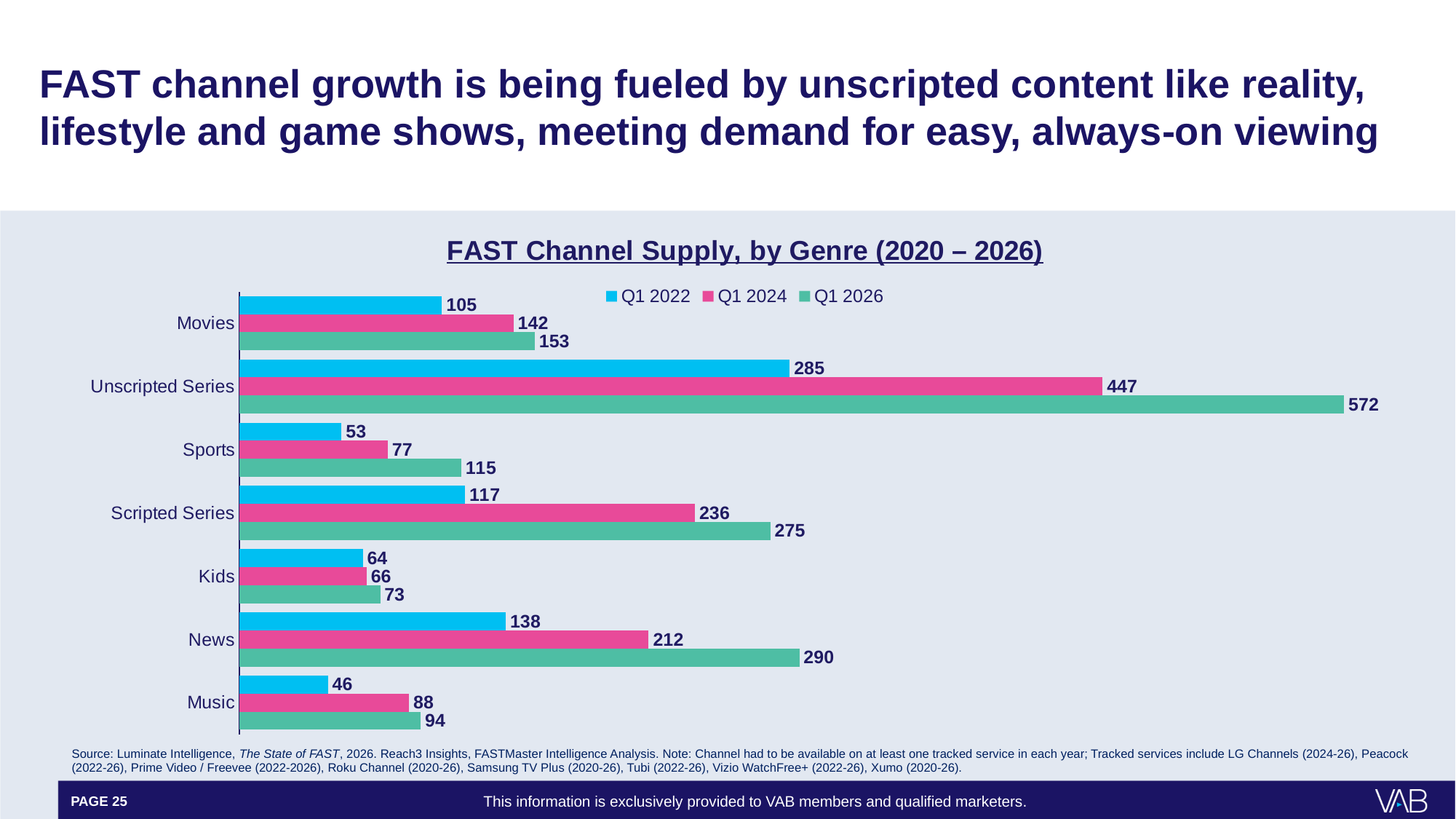
Which is larger, the Q1 2026 value for News or the Q1 2026 value for Scripted Series? News Which genre has the highest Q1 2026 value? Unscripted Series What kind of chart is shown on the slide? Bar chart How many series does the legend list? 3 What is the Q1 2024 value for Sports? 77 What is the difference between the Q1 2026 and Q1 2022 values for Unscripted Series? 287 What is the Q1 2026 value for Unscripted Series? 572 What is the title of the chart? FAST Channel Supply, by Genre (2020 – 2026) What is the Q1 2022 value for News? 138 Which genre has the lowest Q1 2022 value? Music How many genres are shown on the chart? 7 What is the difference between the Q1 2024 values for Scripted Series and News? 24